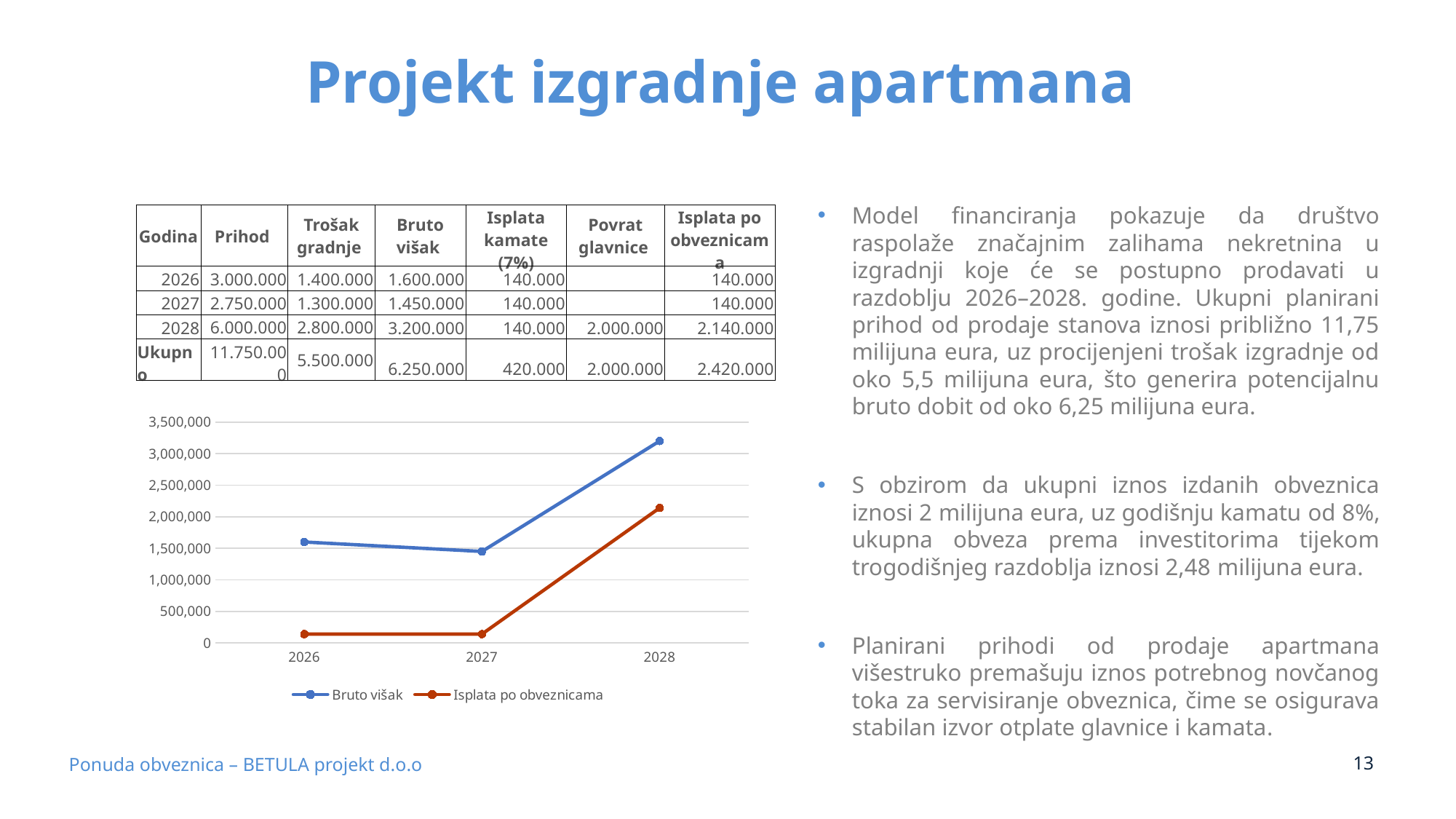
In which year is Bruto višak highest? 2028 How many series does the chart's legend list? 2 How many years are plotted along the x axis of the chart? 3 What is the difference between Bruto višak and Isplata po obveznicama in 2028, using the values printed in the table? 1.060.000 Is the value for Isplata po obveznicama in 2026 greater or less than 500,000? less What is the value of Bruto višak for 2027, as printed in the table on the slide? 1.450.000 What kind of chart is shown on the slide? line chart Is the value for Bruto višak in 2028 greater or less than 3,000,000? greater In which year is Bruto višak lowest? 2027 Which colour is used for the Bruto višak line in the chart? blue In 2028, which is larger: Bruto višak or Isplata po obveznicama? Bruto višak How does the Bruto višak line move from 2026 to 2028? falls from 2026 to 2027, then rises sharply in 2028